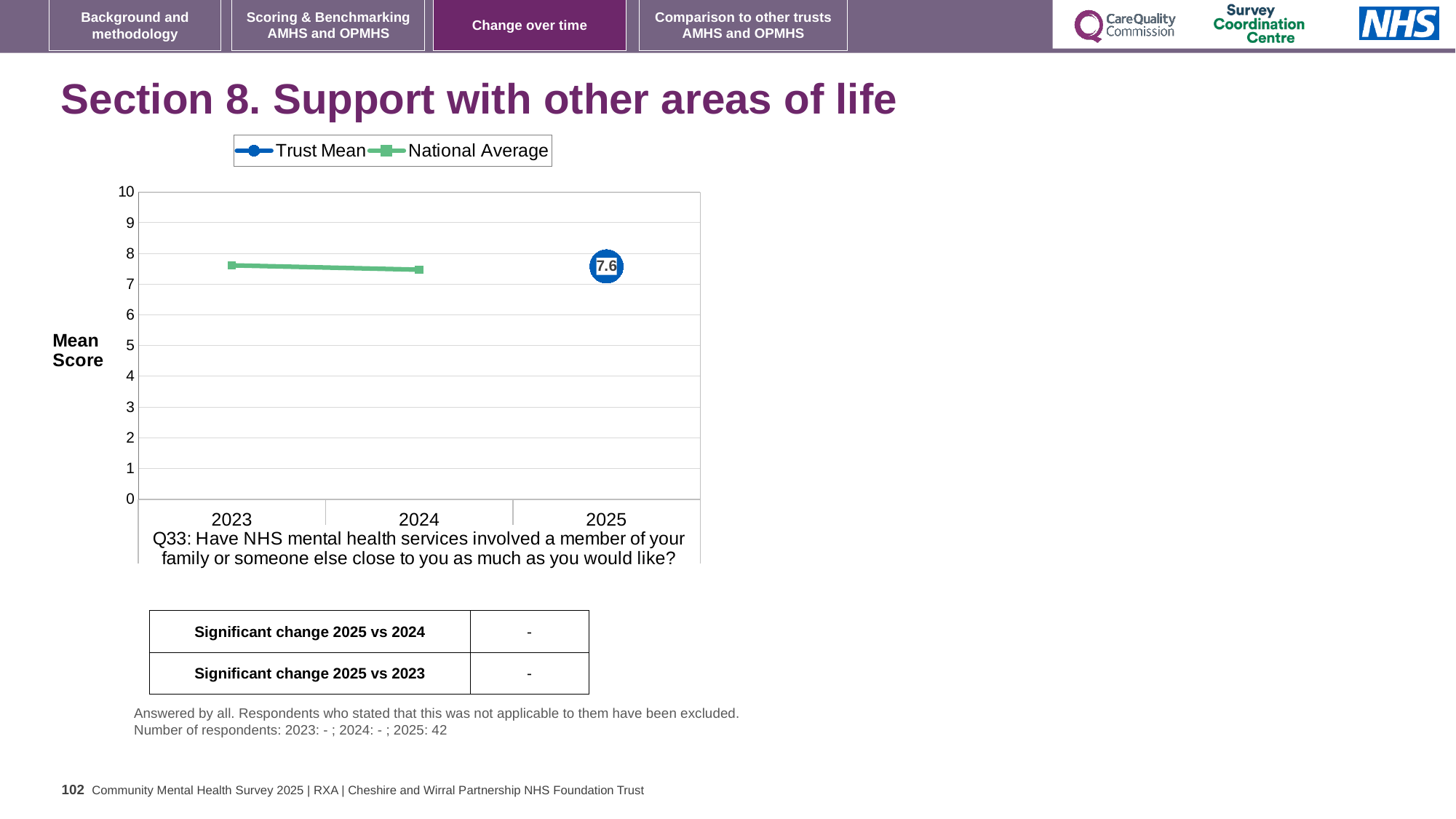
What is the label on the y axis of the chart? Mean Score How many series does the legend list? 2 Which series is shown in green in the chart? National Average Is the Trust Mean value for 2025 greater or less than 5? greater What kind of chart is shown on the slide? line chart Is the National Average value for 2023 greater or less than 5? greater Is the National Average value for 2024 greater or less than 8? less How many years are shown on the x axis of the chart? 3 What is the Trust Mean value shown for 2025? 7.6 Does the National Average rise or fall from 2023 to 2024? fall What is the highest value shown on the y axis of the chart? 10